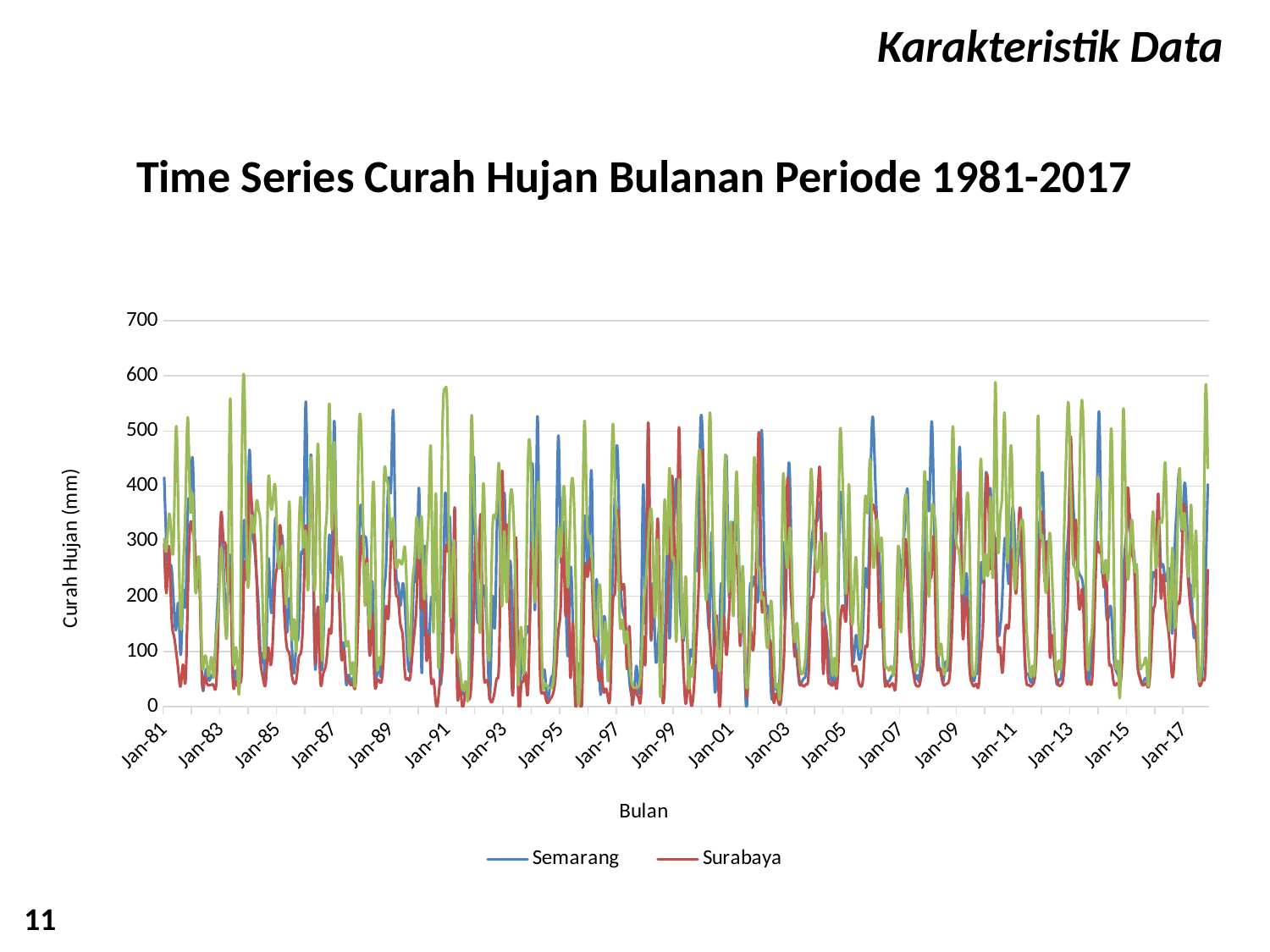
Do the plotted values show a steady rise across the x axis, or do they fluctuate up and down? fluctuate up and down What kind of chart is shown on the slide? line chart Is the highest value reached by the Semarang line greater or less than 400? greater Is the highest value plotted on the chart greater or less than 700? less What is the title of the chart? Time Series Curah Hujan Bulanan Periode 1981-2017 How many year labels are shown along the x axis? 19 How many series does the legend list? 2 Which colour represents Surabaya in the chart? red Is the lowest value reached by the Surabaya line greater or less than 100? less